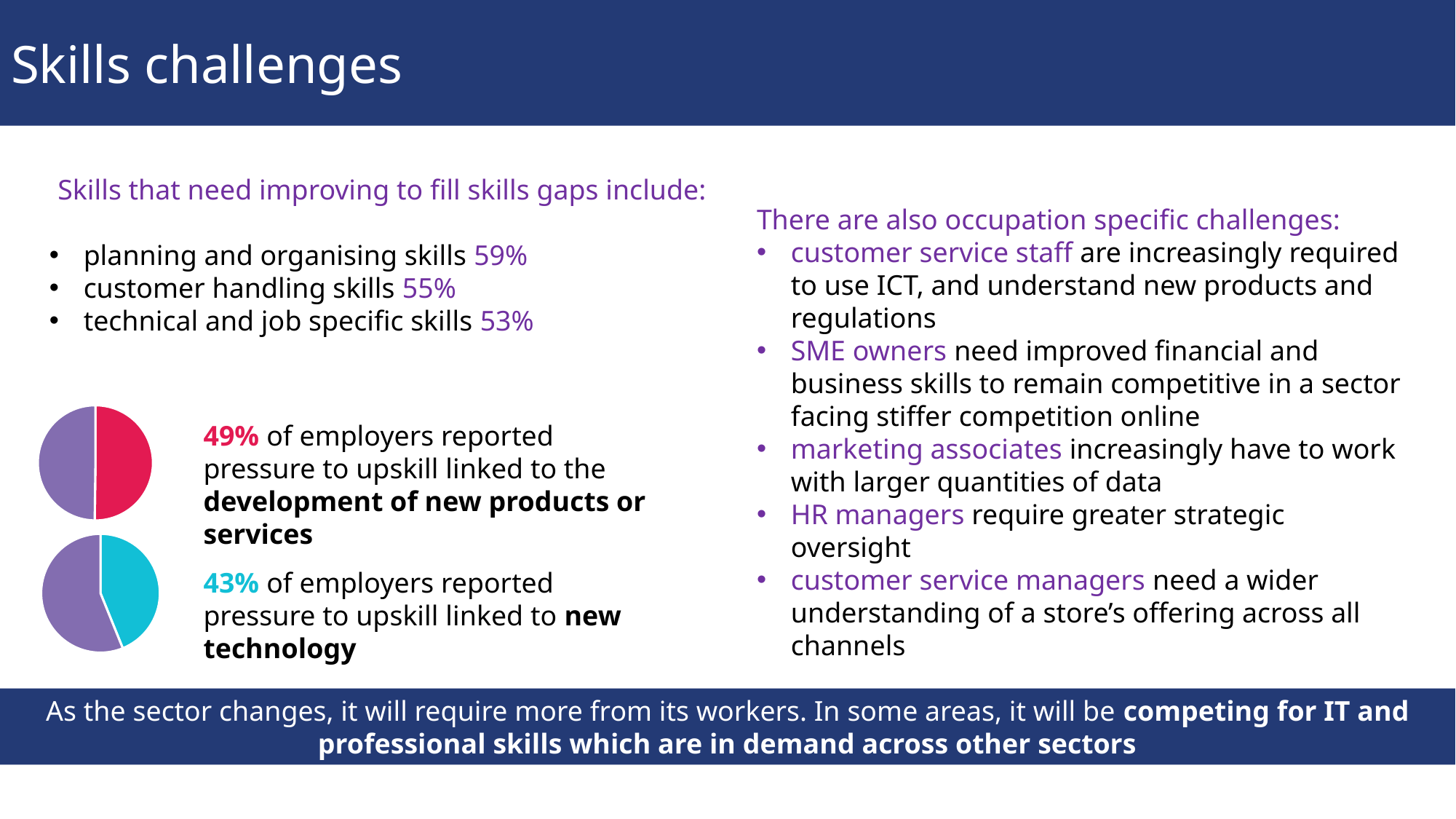
What colour is the slice representing the 49% of employers in the upper pie chart? Red/pink What kind of charts are shown on the left side of the slide? Pie charts What is the difference in percentage points between the share of employers reporting upskilling pressure linked to new products or services (upper pie) and the share linked to new technology (lower pie)? 6 percentage points What colour is the slice representing the 43% of employers in the lower pie chart? Cyan/turquoise How many slices does each pie chart on the slide have? 2 In the lower pie chart, what share of employers reported pressure to upskill linked to new technology? 43% In the upper pie chart, what share of employers reported pressure to upskill linked to the development of new products or services? 49% How many pie charts are on the slide? 2 Which is larger: the share of employers reporting upskilling pressure linked to new products or services, or the share linked to new technology? New products or services In the lower pie chart, is the highlighted slice for new technology greater or less than 50%? less